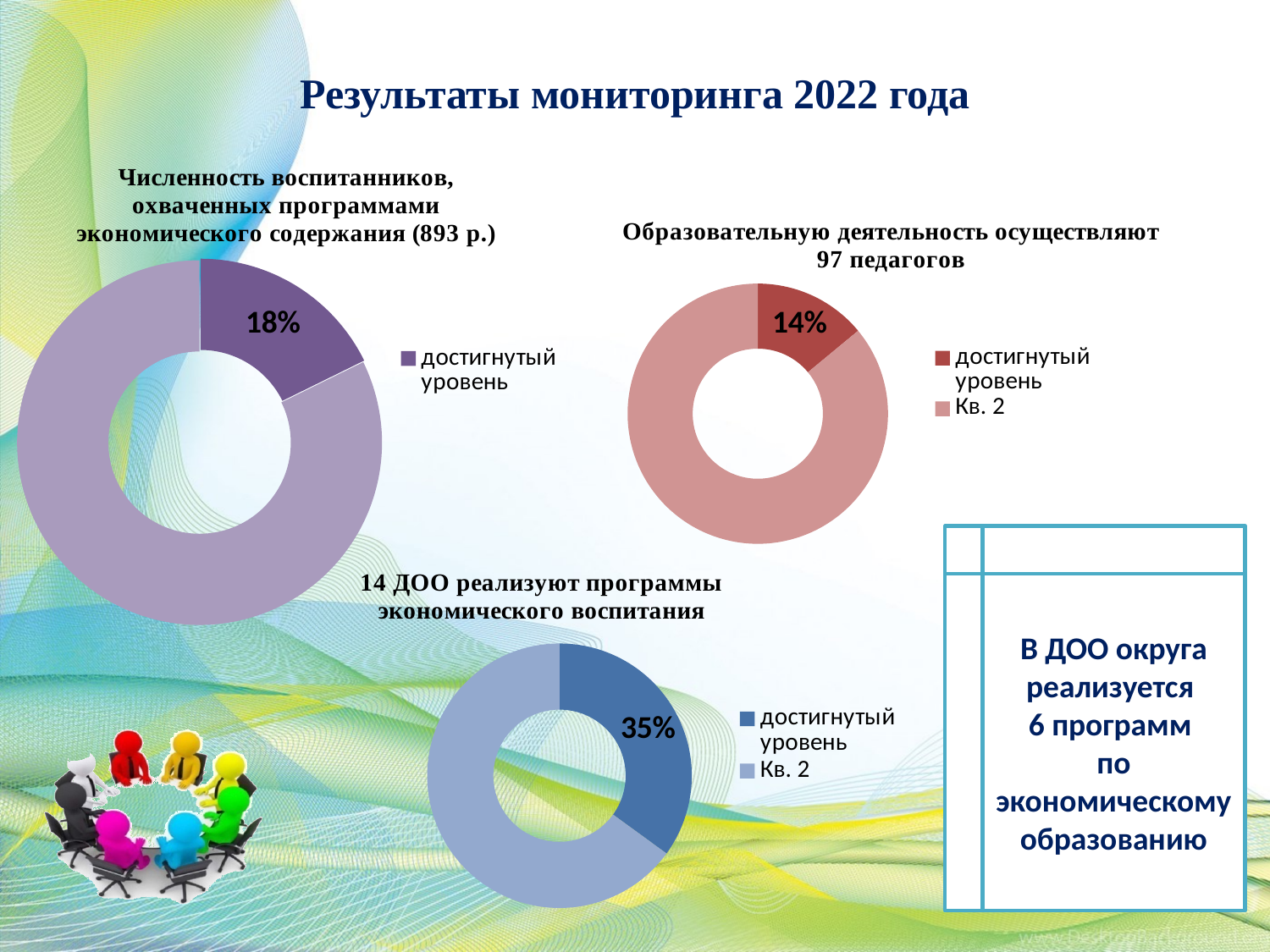
What colour is the 'достигнутый уровень' slice in the chart '14 ДОО реализуют программы экономического воспитания'? Dark blue In the chart '14 ДОО реализуют программы экономического воспитания', what share of the doughnut does 'достигнутый уровень' take? 35% In the chart 'Образовательную деятельность осуществляют 97 педагогов', what percentage is shown for 'достигнутый уровень'? 14% How many entries does the legend of the chart 'Численность воспитанников, охваченных программами экономического содержания (893 р.)' list? 1 What kind of chart is used for 'Численность воспитанников, охваченных программами экономического содержания (893 р.)'? Doughnut (pie) chart Among the three doughnut charts on the slide, which one has the lowest labelled 'достигнутый уровень' percentage? Образовательную деятельность осуществляют 97 педагогов Among the three doughnut charts on the slide, which one has the highest labelled 'достигнутый уровень' percentage? 14 ДОО реализуют программы экономического воспитания In the chart 'Численность воспитанников, охваченных программами экономического содержания (893 р.)', what percentage is shown for 'достигнутый уровень'? 18% How many entries does the legend of the chart 'Образовательную деятельность осуществляют 97 педагогов' list? 2 In the chart 'Образовательную деятельность осуществляют 97 педагогов', what is the name of the second legend entry besides 'достигнутый уровень'? Кв. 2 What is the difference between the 'достигнутый уровень' percentage in the chart '14 ДОО реализуют программы экономического воспитания' and in the chart 'Образовательную деятельность осуществляют 97 педагогов'? 21% Which chart shows the larger 'достигнутый уровень' percentage: '14 ДОО реализуют программы экономического воспитания' or 'Образовательную деятельность осуществляют 97 педагогов'? 14 ДОО реализуют программы экономического воспитания